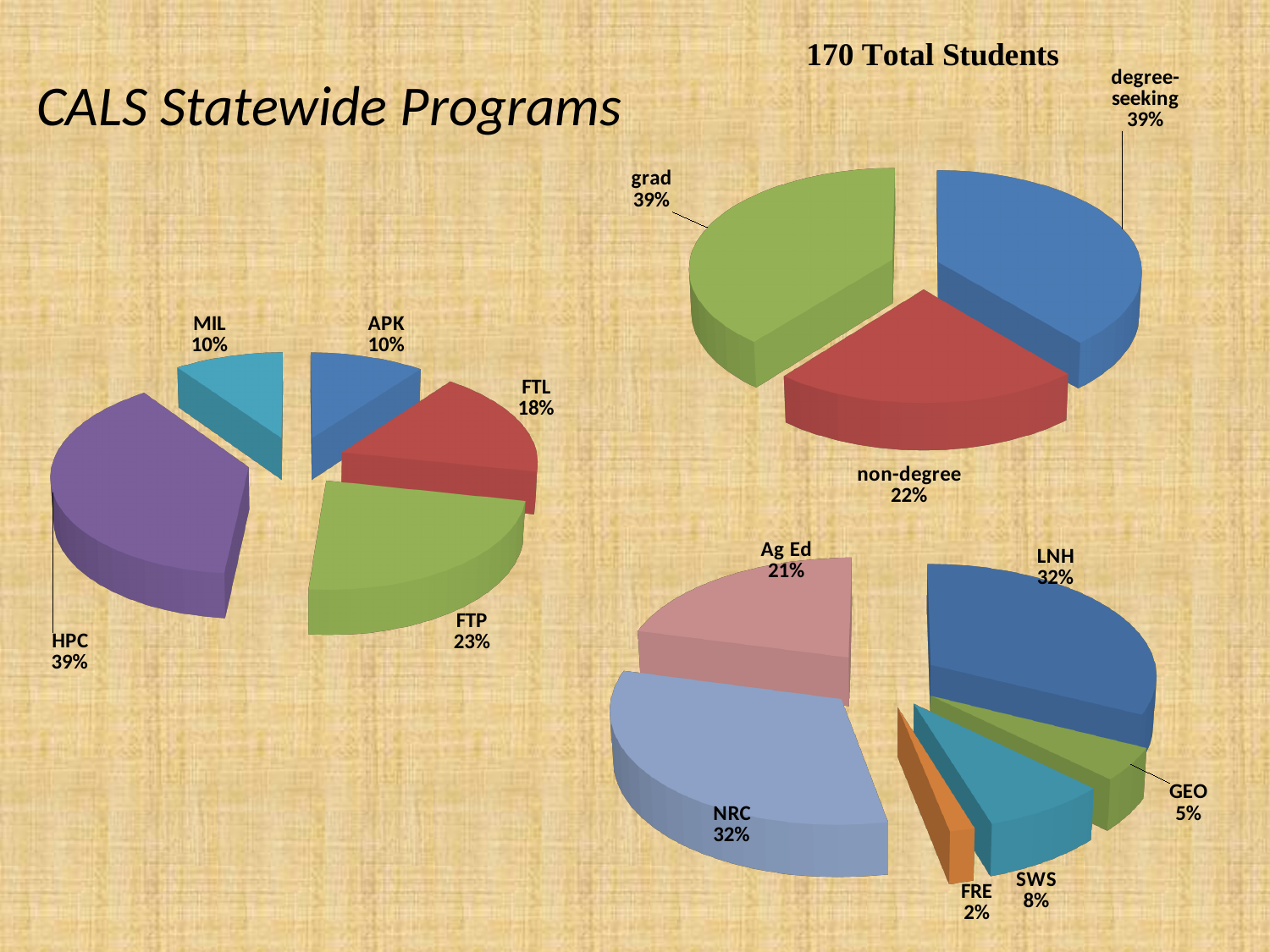
In the bottom-right pie chart, what share does Ag Ed have? 21% In the pie chart on the left of the slide, which category has the largest share? HPC How many categories are shown in the pie chart on the left of the slide? 5 In the top-right pie chart, which category has the smallest share? non-degree How many categories are shown in the bottom-right pie chart? 6 In the pie chart on the left of the slide, what is the difference between the FTP share and the FTL share? 5% What kind of chart is the top-right chart on the slide? pie chart In the bottom-right pie chart, which category has the smallest share? FRE In the bottom-right pie chart, what is the difference between the SWS share and the GEO share? 3% In the pie chart on the left of the slide, which is larger, FTL or APK? FTL In the top-right pie chart, what share is non-degree? 22% In the pie chart on the left of the slide, what share does HPC have? 39%